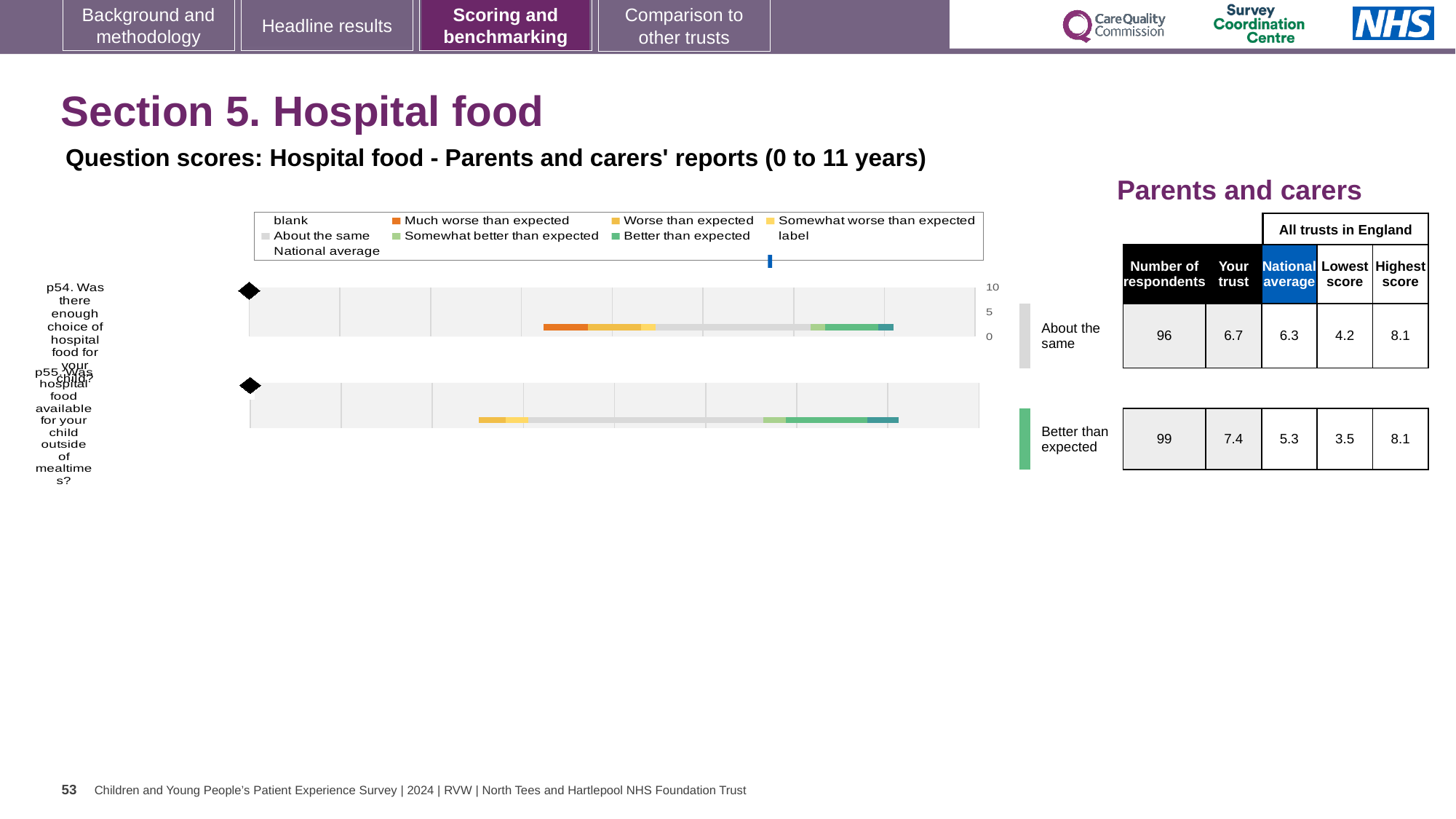
In the table beside the chart, what is the 'Your trust' score for the 'About the same' row? 6.7 In the table beside the chart, what is the number of respondents for the 'Better than expected' row? 99 What colour does the legend use for 'Much worse than expected'? orange How many entries does the chart legend list? 9 In the table beside the chart, what is the 'Your trust' score for the 'Better than expected' row? 7.4 In the table beside the chart, which row has the higher 'Your trust' score, 'About the same' or 'Better than expected'? Better than expected In the table beside the chart, what is the difference between the 'Your trust' score and the national average for the 'Better than expected' row? 2.1 In the table beside the chart, what is the lowest score for the 'Better than expected' row? 3.5 What is the label of the first (top) bar in the chart? p54. Was there enough choice of hospital food for your child? How many question categories (bars) are plotted in the chart? 2 What kind of chart is shown on the slide? bar chart In the table beside the chart, what is the national average for the 'About the same' row? 6.3